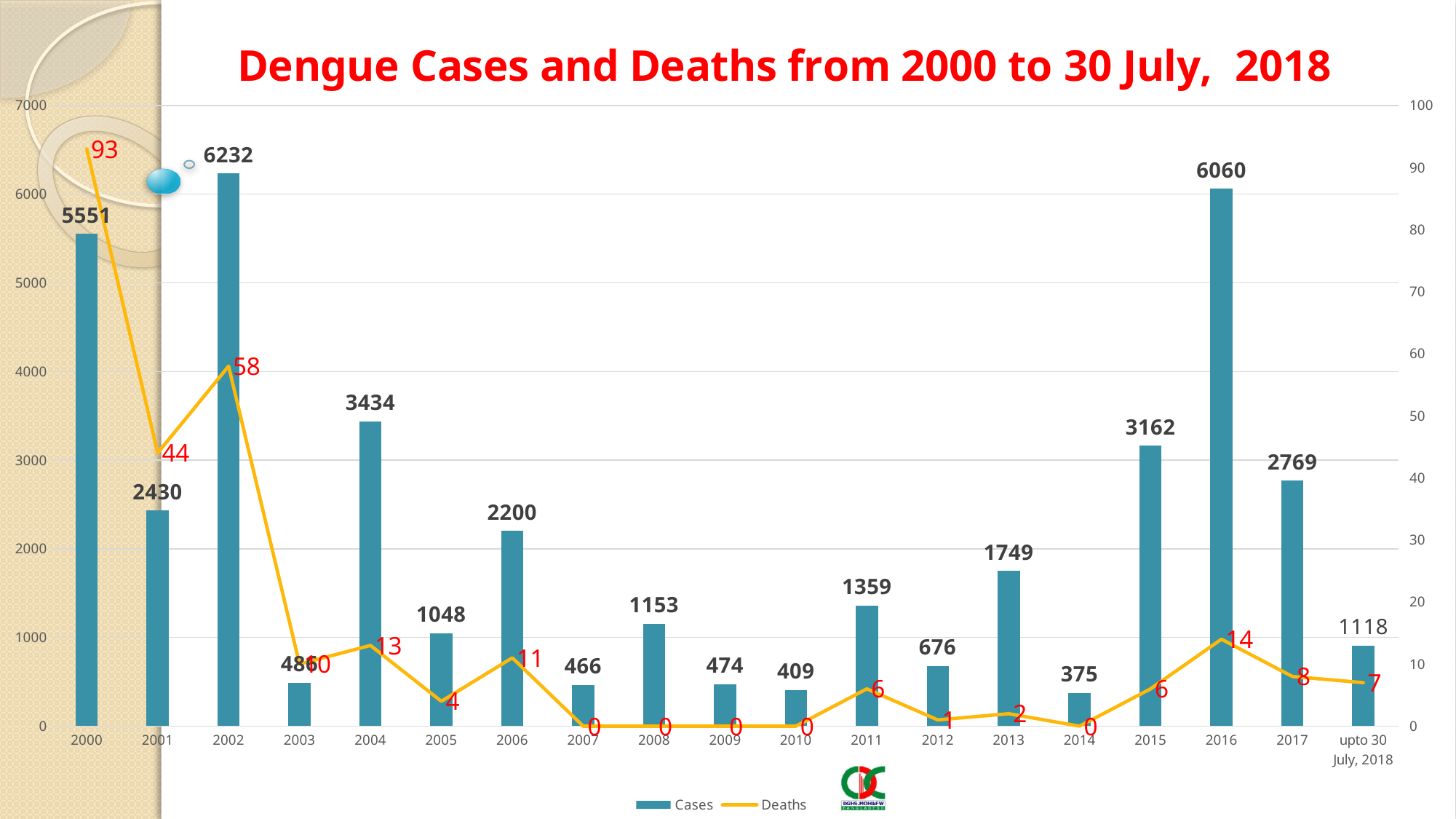
How many dengue cases were recorded in 2002? 6232 Which year had more dengue cases, 2004 or 2017? 2004 How many dengue cases were recorded up to 30 July, 2018? 1118 Which year has the highest number of dengue deaths? 2000 What is the difference in dengue cases between 2016 and 2015? 2898 How many dengue deaths were recorded in 2016? 14 What is the title of the chart? Dengue Cases and Deaths from 2000 to 30 July, 2018 What kind of chart is used to show the Cases series? Bar chart Which year has the highest number of dengue cases? 2002 How many categories (years/periods) are shown on the x axis? 19 How many series does the legend list? 2 How many dengue deaths were recorded in 2000? 93